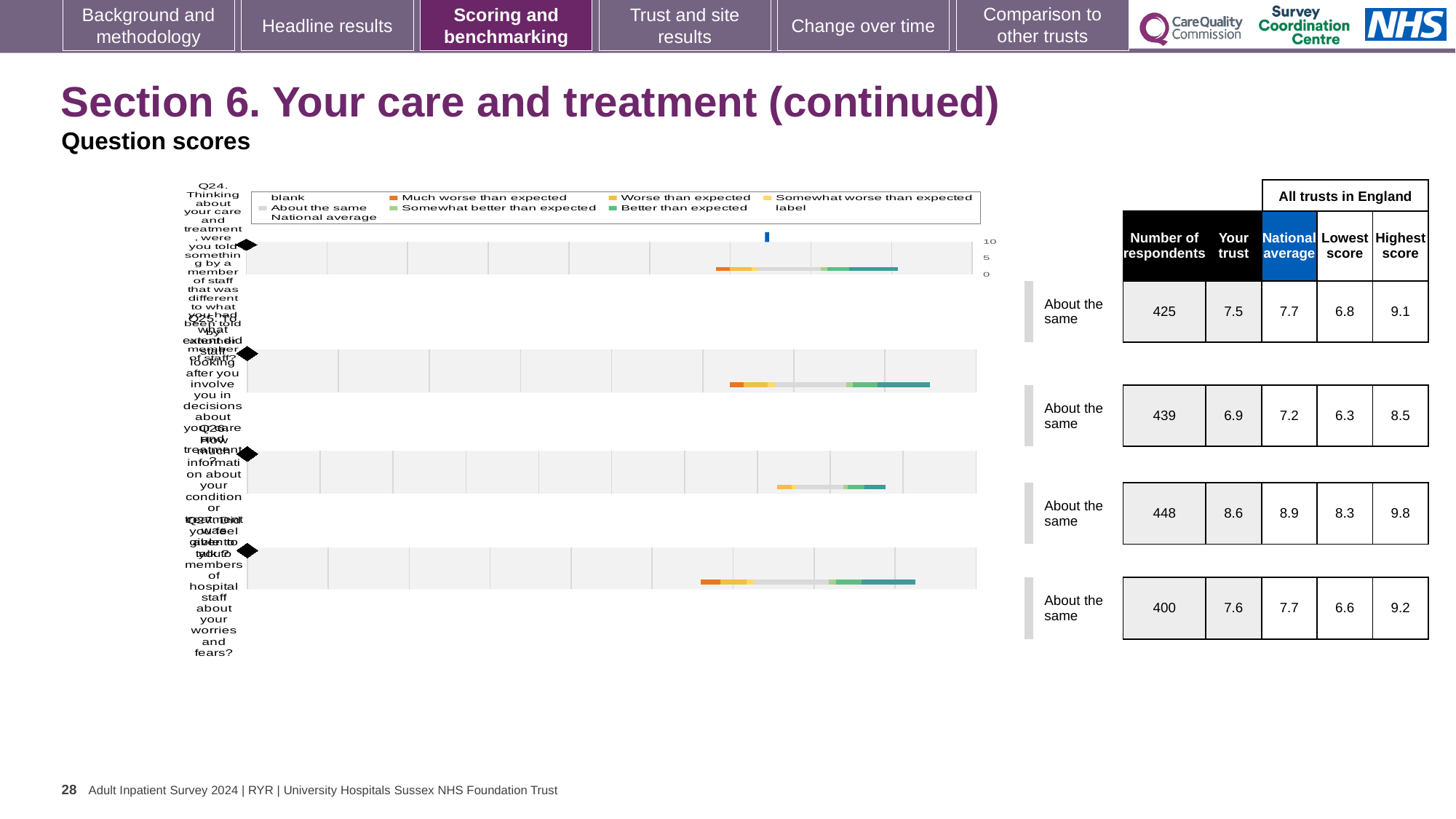
In the table beside the charts, which row has the highest 'Your trust' score? Q26 (third row), 8.6 In the table beside the charts, what is the 'Your trust' score for the second row (Q25)? 6.9 In the table beside the charts, what is the number of respondents for the first row (Q24)? 425 How many question charts (rows) are shown on the slide? 4 In the table beside the charts, is the 'Your trust' score for the first row (Q24) larger or smaller than the national average? smaller In the table beside the charts, what is the difference between the national average and the 'Your trust' score for the second row (Q25)? 0.3 How many entries does the legend above the charts list? 9 Which legend entry is shown in dark orange? Much worse than expected In the table beside the charts, what is the national average for the third row (Q26)? 8.9 What benchmark category label is shown to the right of the first chart (Q24)? About the same In the table beside the charts, what is the highest score for the fourth row (Q27)? 9.2 What kind of chart is used for each of the question rows on the slide? bar chart